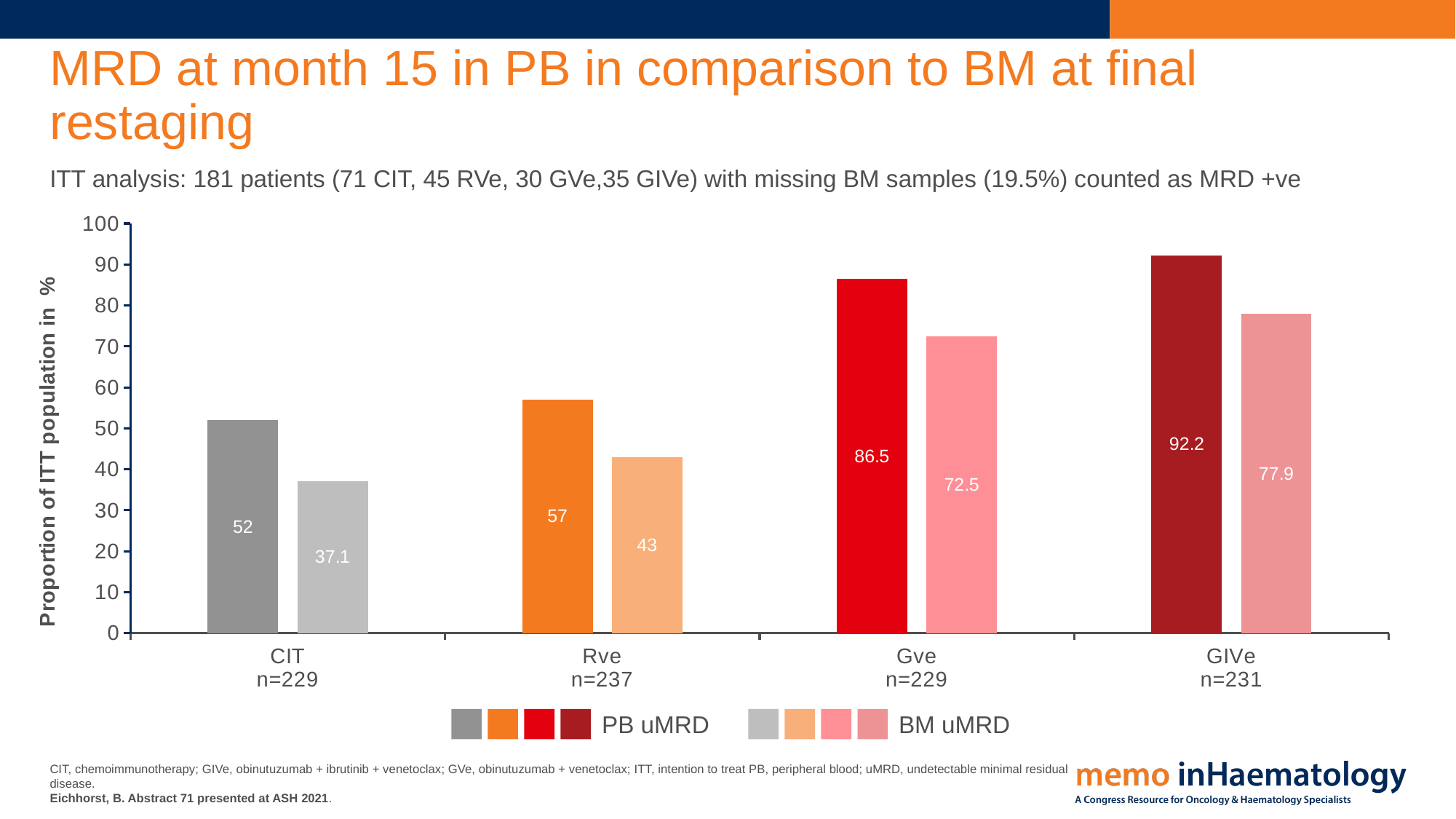
How many series does the legend list? 2 What is the BM uMRD value for GIVe? 77.9 Is the PB uMRD value for Rve greater or less than 50? greater What is the difference between the PB uMRD and BM uMRD values for Gve? 14 How many treatment arms are shown on the x axis? 4 What kind of chart is shown on the slide? Bar chart Which treatment arm has the lowest BM uMRD value? CIT What is the y-axis label of the chart? Proportion of ITT population in % What is the BM uMRD value for Rve? 43 Which treatment arm has the highest PB uMRD value? GIVe Which is larger for CIT: the PB uMRD value or the BM uMRD value? PB uMRD What is the PB uMRD value for CIT? 52